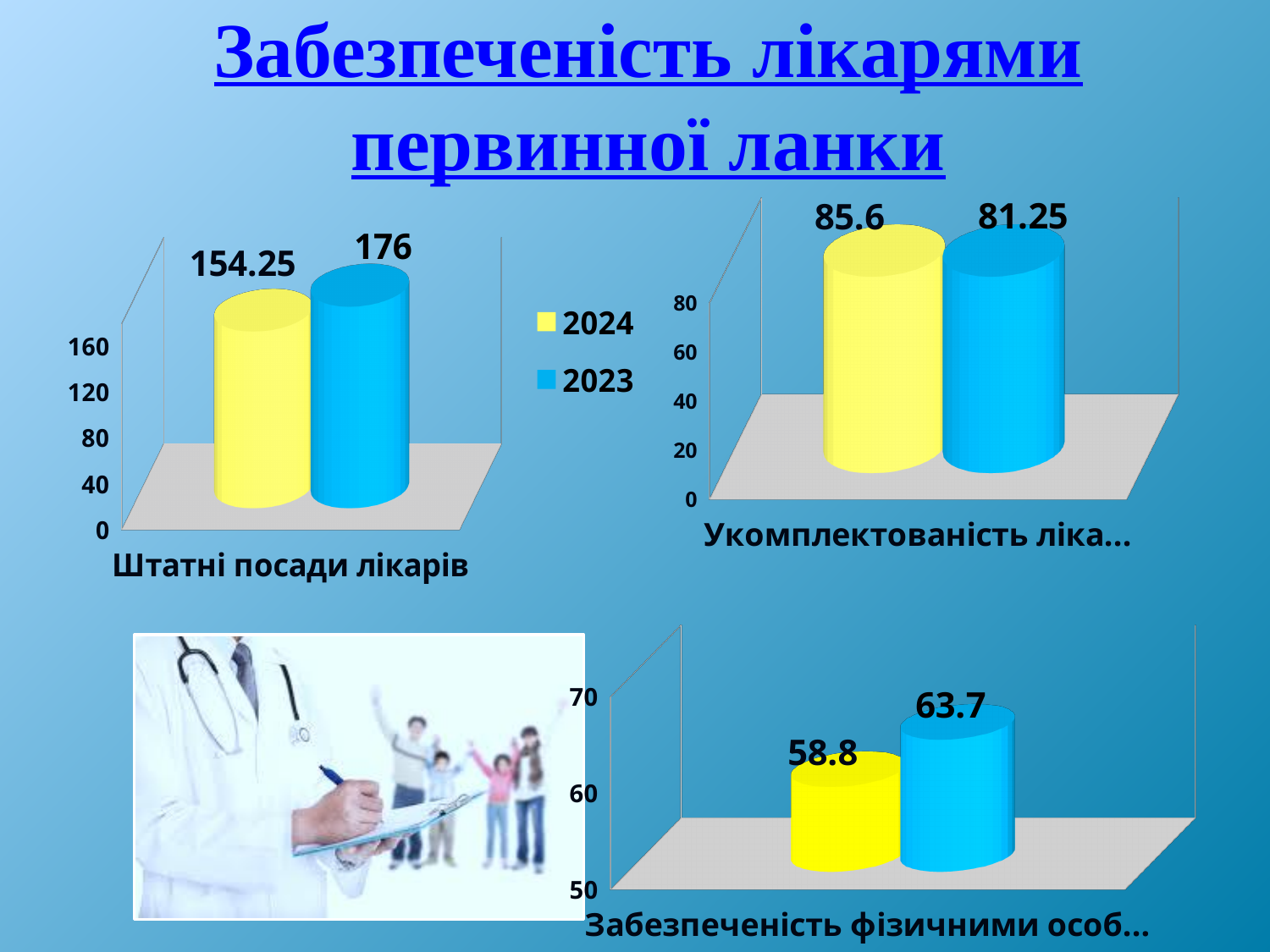
In the chart titled 'Штатні посади лікарів', which year has the higher value? 2023 In the top-right chart ('Укомплектованість ліка...'), which year has the higher value? 2024 In the chart titled 'Штатні посади лікарів', what is the value for 2023? 176 What kind of chart is the chart titled 'Штатні посади лікарів'? Bar chart In the bottom-right chart ('Забезпеченість фізичними особ...'), what is the value for 2023? 63.7 In the bottom-right chart ('Забезпеченість фізичними особ...'), what is the value for 2024? 58.8 In the top-right chart ('Укомплектованість ліка...'), what is the value for 2023? 81.25 In the chart titled 'Штатні посади лікарів', what is the value for 2024? 154.25 In the top-right chart ('Укомплектованість ліка...'), what is the value for 2024? 85.6 How many series does the legend on the slide list? 2 In the chart titled 'Штатні посади лікарів', what is the difference between the 2023 and 2024 values? 21.75 In the bottom-right chart ('Забезпеченість фізичними особ...'), what is the difference between the 2023 and 2024 values? 4.9